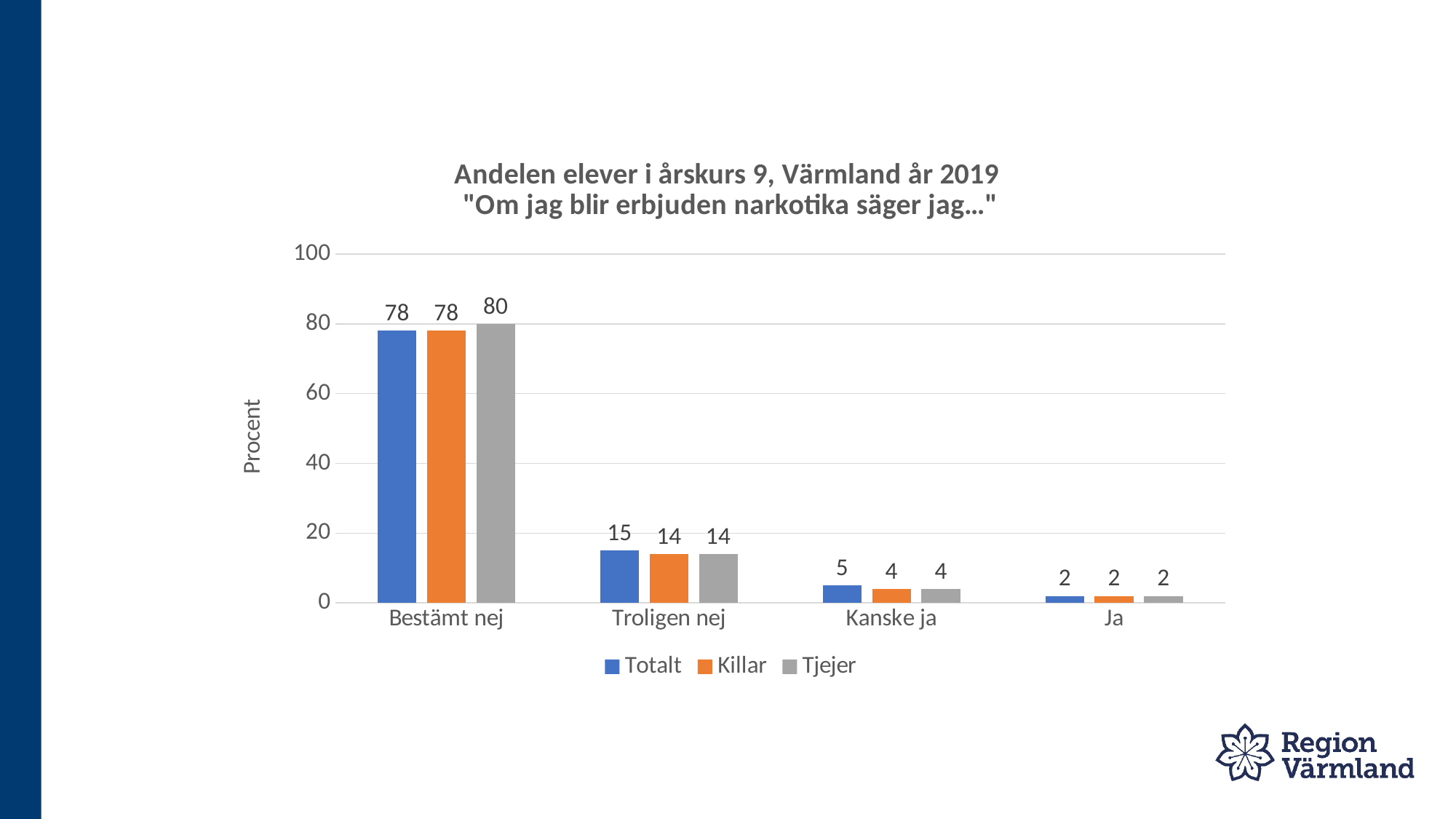
What is the value for Totalt in the Troligen nej category? 15 Which category has the lowest value for the Tjejer series? Ja What kind of chart is shown on the slide? bar chart Is the value for Totalt in the Bestämt nej category greater or less than 60? greater Which category has the highest value for the Totalt series? Bestämt nej What is the difference between the Tjejer and Killar values in the Bestämt nej category? 2 What is the label of the y axis? Procent How many categories are shown on the x axis? 4 What is the value for Tjejer in the Bestämt nej category? 80 What is the value for Killar in the Kanske ja category? 4 How many series does the legend list? 3 In the Troligen nej category, which is larger: the Totalt value or the Killar value? Totalt